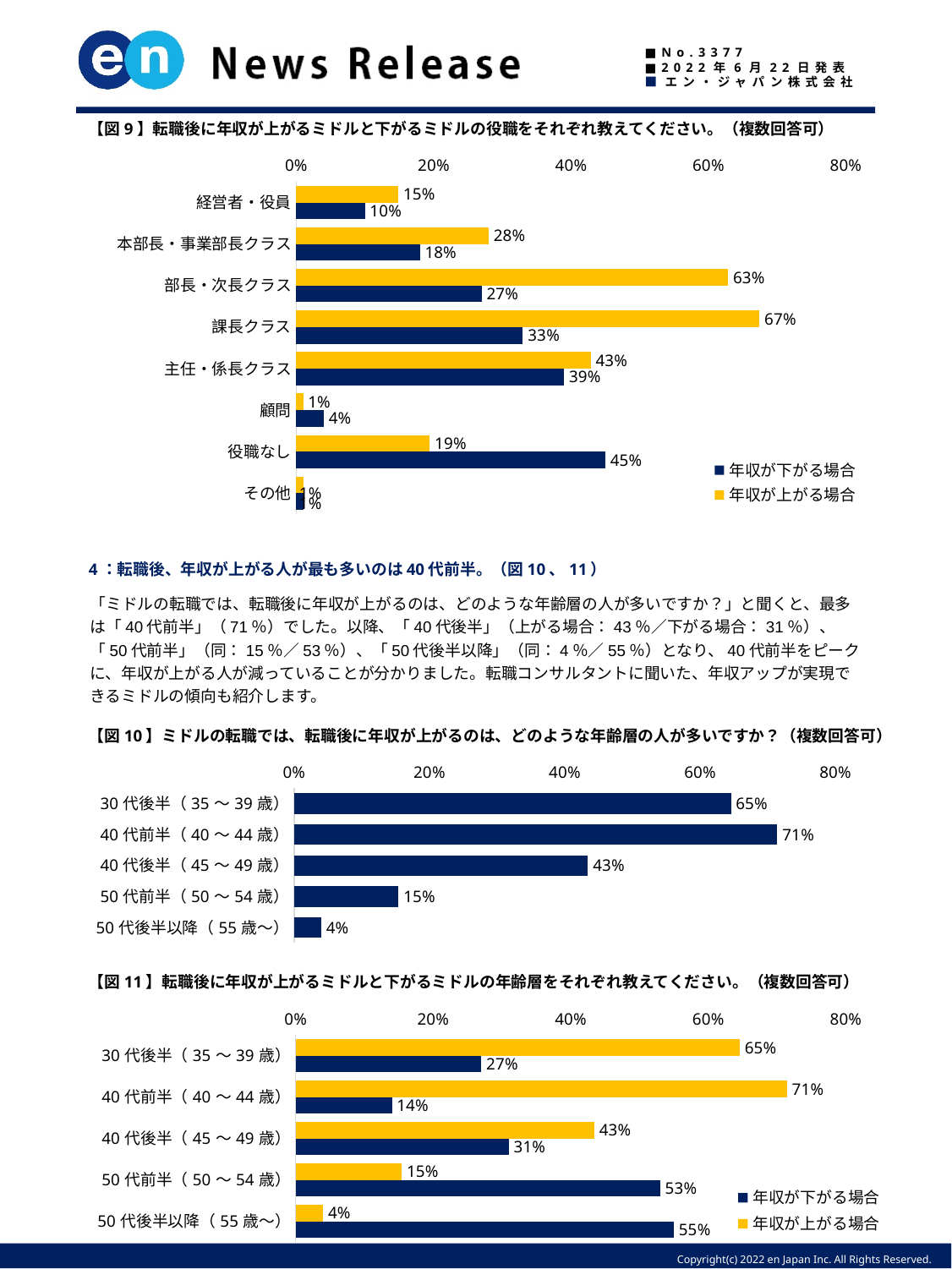
In 図11, which is larger for 40代後半（45～49歳）: the 年収が上がる場合 value or the 年収が下がる場合 value? 年収が上がる場合 What kind of chart is 図10? bar chart In 図11, what is the value for 50代前半（50～54歳） in the 年収が下がる場合 series? 53% In 図10, what is the value for 40代前半（40～44歳）? 71% In 図11, which category has the highest value in the 年収が下がる場合 series? 50代後半以降（55歳～） In 図9, how many series does the legend list? 2 In 図9, what is the value for 課長クラス in the 年収が上がる場合 series? 67% In 図10, how many categories are shown? 5 In 図10, which category has the lowest value? 50代後半以降（55歳～） In 図9, what is the value for 役職なし in the 年収が下がる場合 series? 45% In 図9, which category has the highest value in the 年収が上がる場合 series? 課長クラス In 図9, what is the difference between the 年収が上がる場合 and 年収が下がる場合 values for 部長・次長クラス? 36%